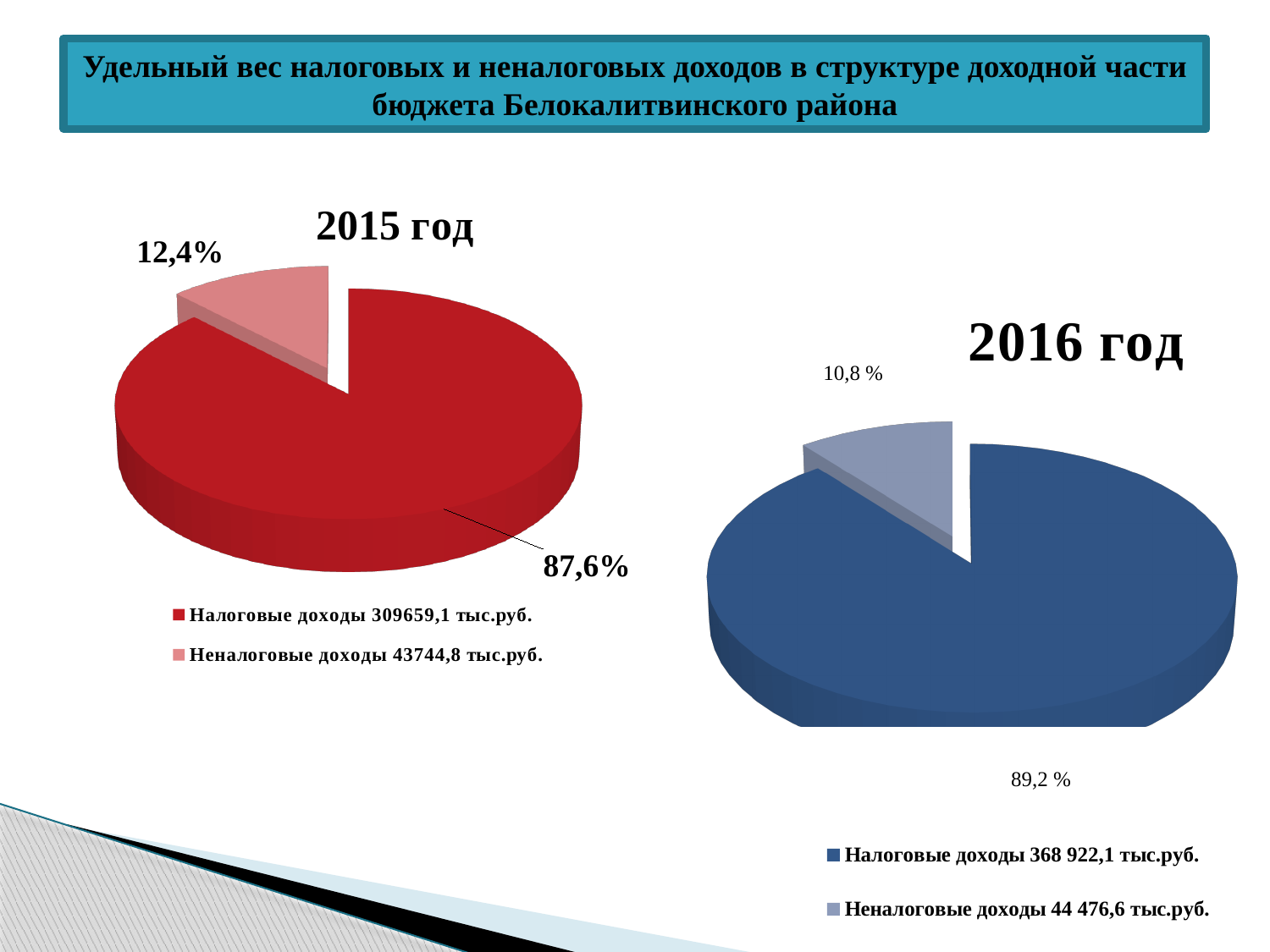
In the "2015 год" chart, which slice is the largest? Налоговые доходы In the "2015 год" chart, what amount in тыс.руб. does the legend give for Неналоговые доходы? 43744,8 тыс.руб. In the "2015 год" chart, what is the difference in percentage points between the Налоговые доходы and Неналоговые доходы slices? 75,2 In the "2016 год" chart, what share of the pie is labelled for Налоговые доходы? 89,2 % In the "2016 год" chart, which slice is the smallest? Неналоговые доходы Which is larger: the Неналоговые доходы share in the "2015 год" chart or in the "2016 год" chart? 2015 год How many slices does the "2016 год" chart have? 2 What type of chart is the "2015 год" chart? Pie chart In the "2015 год" chart, what share of the pie is labelled for Налоговые доходы? 87,6% In the "2015 год" chart, what share of the pie is labelled for Неналоговые доходы? 12,4% In the "2016 год" chart, what amount in тыс.руб. does the legend give for Налоговые доходы? 368 922,1 тыс.руб.